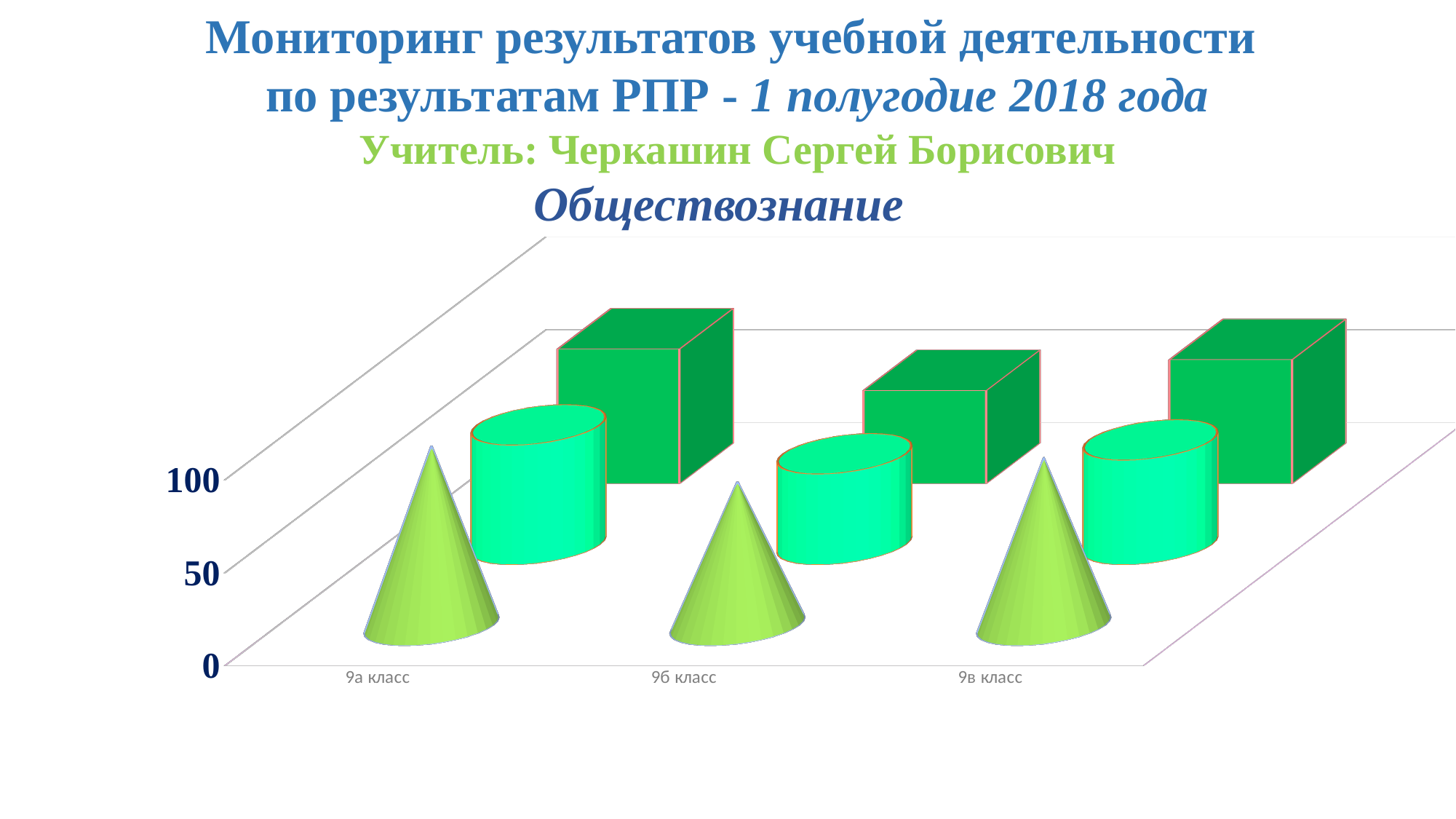
How many classes (categories) are shown on the x axis of the chart? 3 Among the cone-shaped bars, which class has the lowest value? 9б класс Among the cylinder-shaped bars, which class has the highest value? 9а класс Which is larger: the cone-shaped bar for 9а класс or the cone-shaped bar for 9б класс? 9а класс Among the cube-shaped bars, which class has the lowest value? 9б класс Which school subject is named in the slide title above the chart? Обществознание Is the cone-shaped bar for 9б класс greater or less than 50? greater What kind of chart is shown on the slide? bar chart Among the cone-shaped bars, which class has the highest value? 9а класс How many data series (shapes) are plotted for each class in the chart? 3 What is the highest value labelled on the vertical axis of the chart? 100